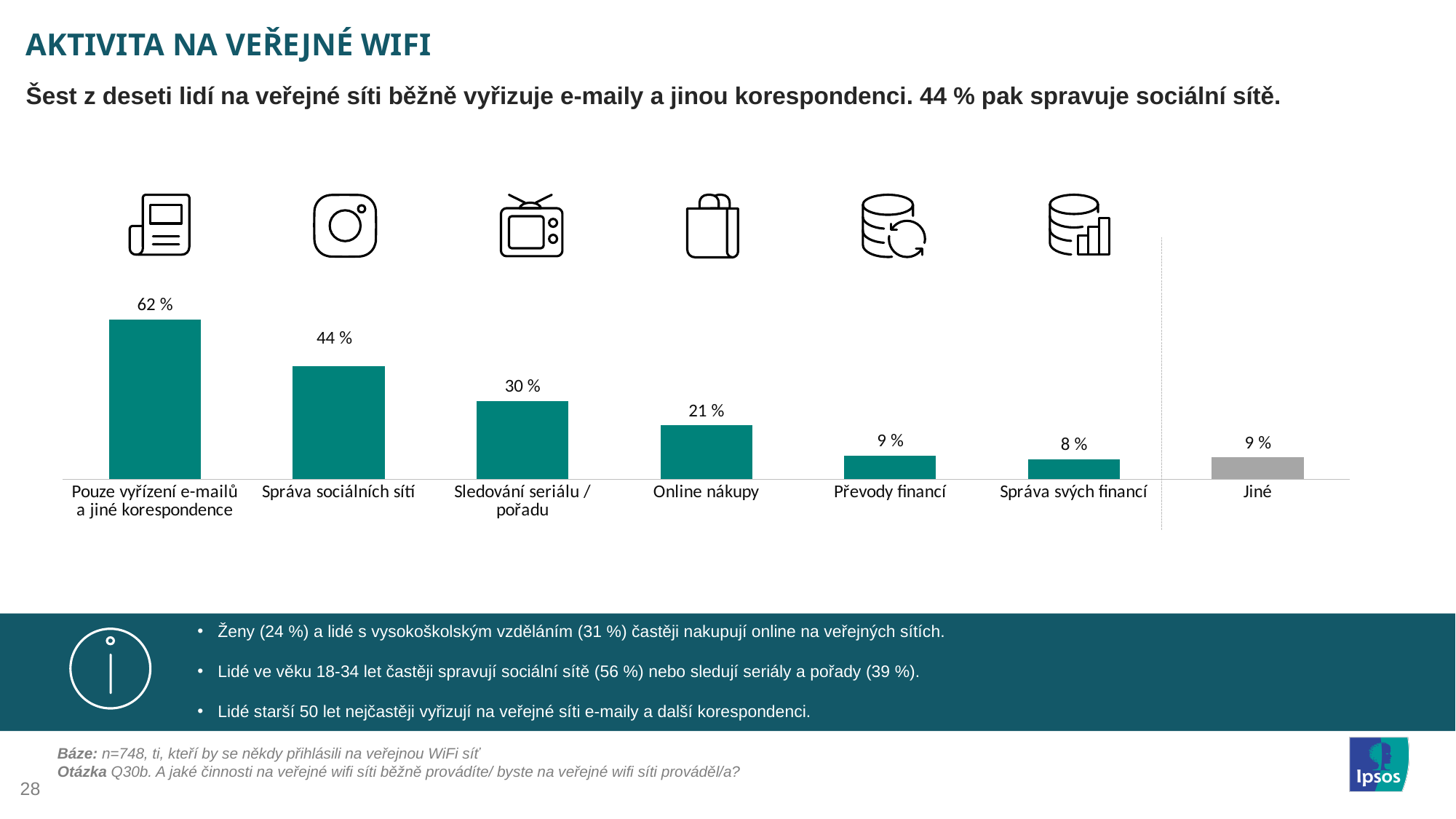
What is the value for Správa svých financí? 8 % How many categories are shown in the chart? 7 Which is larger, the value for Online nákupy or the value for Převody financí? Online nákupy What is the value for Správa sociálních sítí? 44 % What is the difference between the values for Správa sociálních sítí and Sledování seriálu / pořadu? 14 % Which category is shown with a grey bar instead of a teal one? Jiné What is the value for Online nákupy? 21 % What is the value for Pouze vyřízení e-mailů a jiné korespondence? 62 % Which category has the highest value? Pouze vyřízení e-mailů a jiné korespondence Which category has the lowest value? Správa svých financí What kind of chart is shown on the slide? Bar chart Do the values of the teal bars rise or fall from left to right? Fall